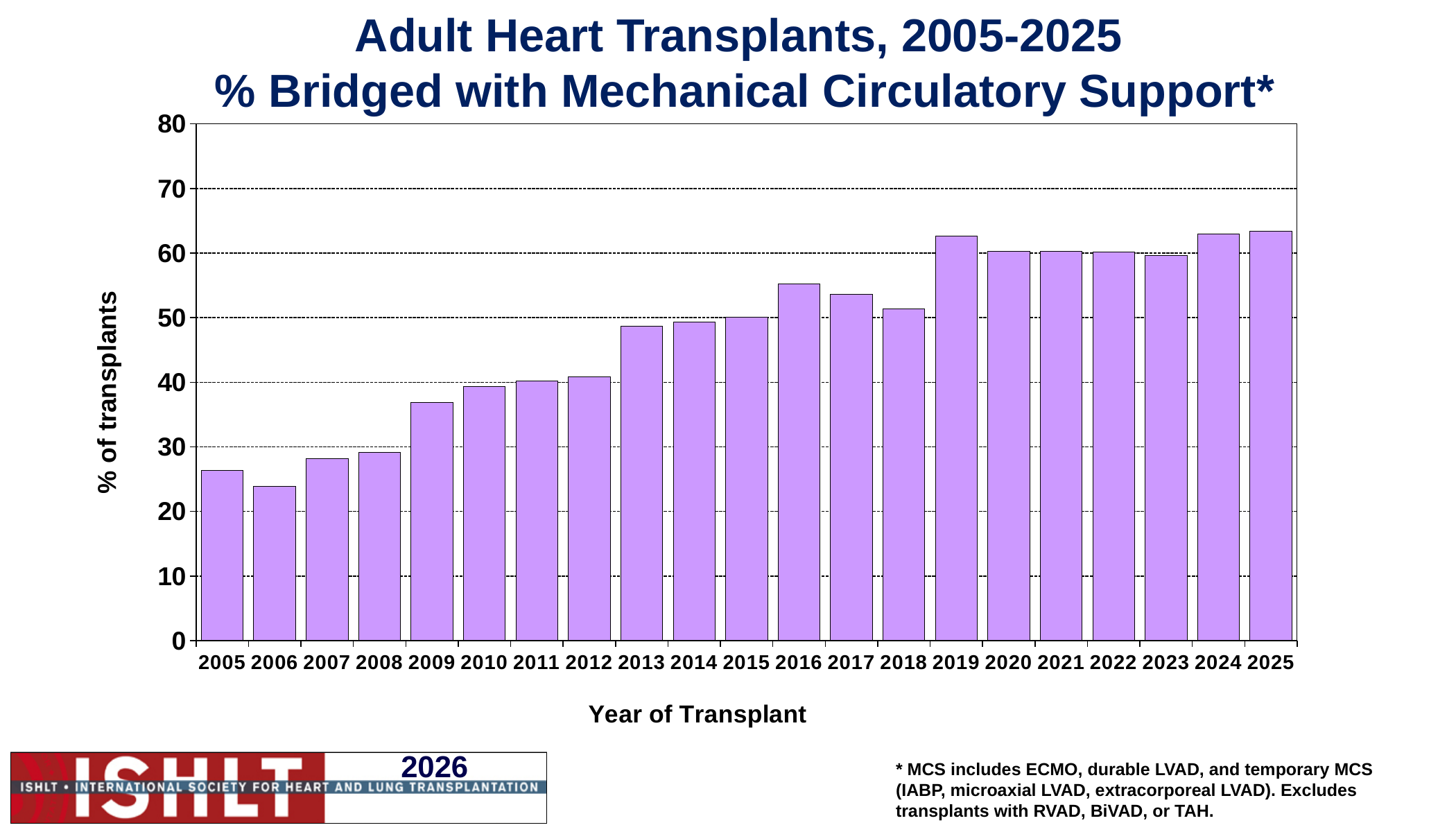
Which is larger, the value for 2019 or the value for 2023? 2019 Is the value for 2006 greater or less than 20? greater Is the value for 2009 greater or less than 40? less Is the value for 2013 greater or less than 50? less What is the label on the y axis of the chart? % of transplants What kind of chart is shown on the slide? bar chart Which is larger, the value for 2016 or the value for 2017? 2016 How many years (bars) are plotted on the chart? 21 Which year has the lowest percentage of transplants bridged with mechanical circulatory support? 2006 Overall, do the values rise or fall from 2005 to 2025? rise